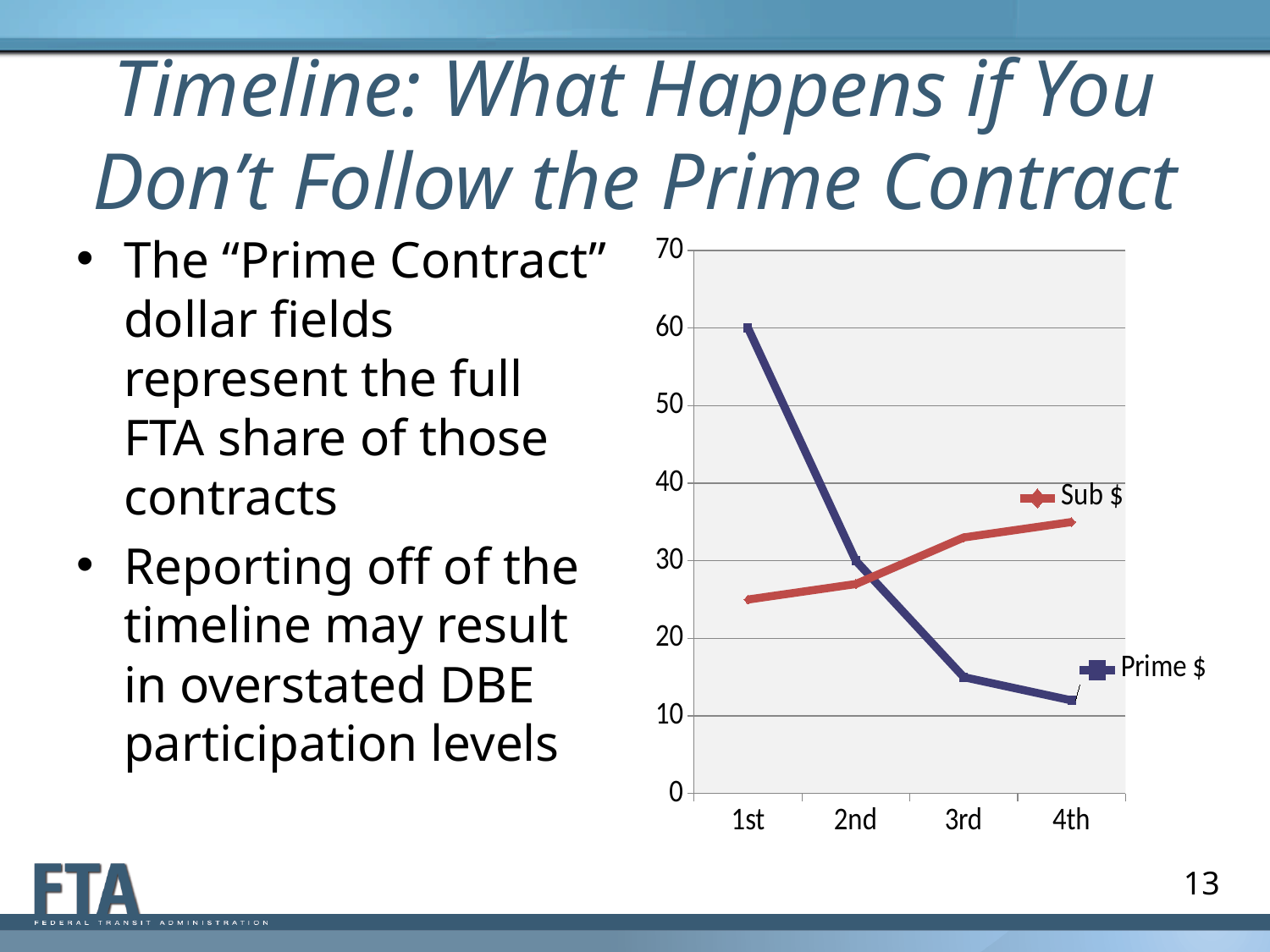
Is the value for Sub $ at 4th greater or less than 30? greater How many categories are shown on the x axis of the chart? 4 Does the Prime $ line rise or fall from 1st to 4th? fall At 1st, which series has the larger value, Prime $ or Sub $? Prime $ What is the value of Prime $ at 1st? 60 How many series does the chart's legend list? 2 At 4th, which series has the larger value, Prime $ or Sub $? Sub $ What kind of chart is shown on the slide? line chart Is the value for Prime $ at 4th greater or less than 20? less Does the Sub $ line rise or fall from 1st to 4th? rise Is the value for Sub $ at 1st greater or less than 30? less What are the two series named in the chart's legend? Sub $ and Prime $